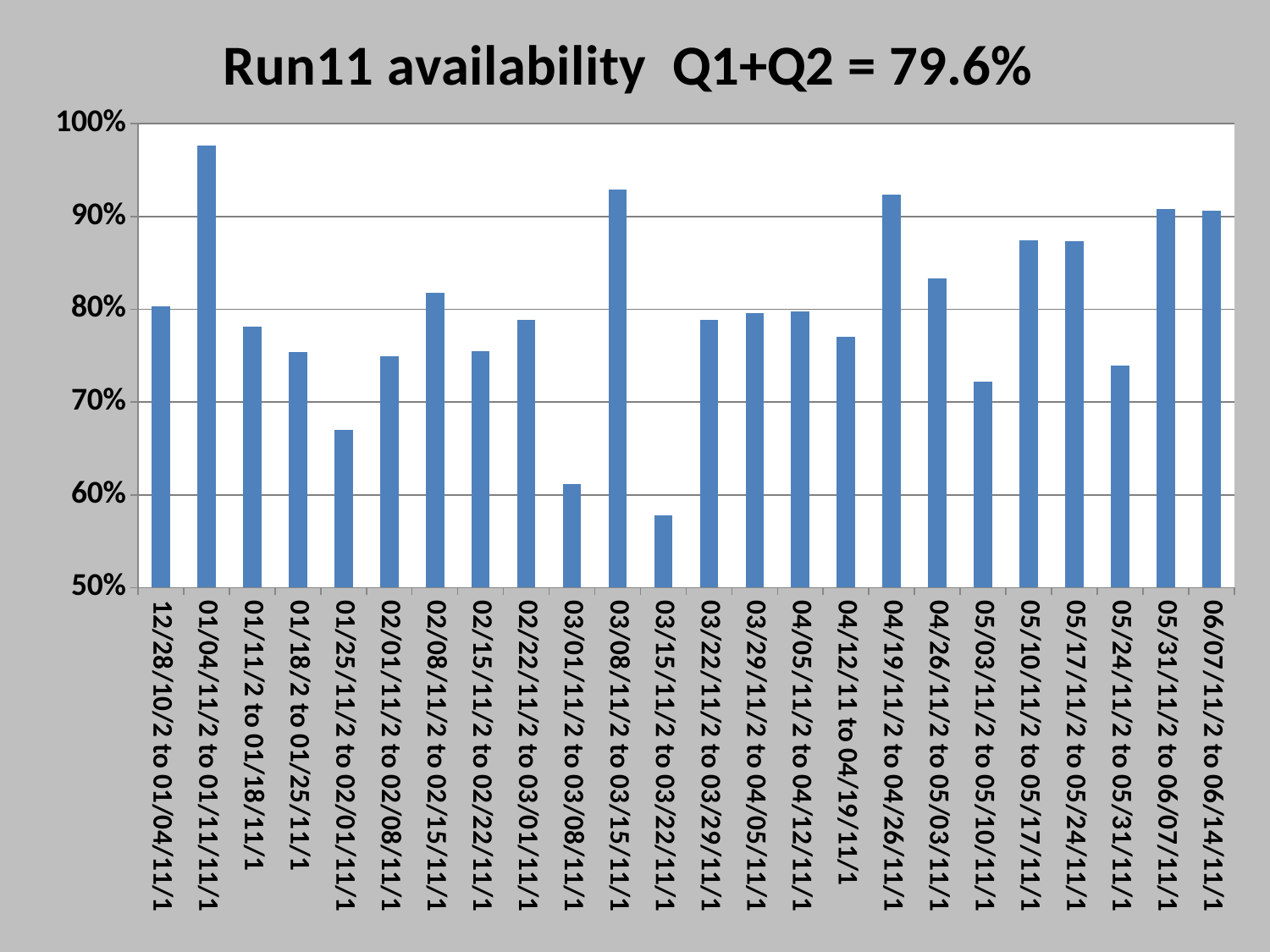
Is the value for 03/01/11/2 to 03/08/11/1 greater or less than 70%? less Which is larger, the value for 02/08/11/2 to 02/15/11/1 or the value for 01/25/11/2 to 02/01/11/1? 02/08/11/2 to 02/15/11/1 Which period has the highest availability? 01/04/11/2 to 01/11/11/1 How many weekly periods (bars) are plotted in the chart? 24 Which period has the lowest availability? 03/15/11/2 to 03/22/11/1 Is the value for 04/12/11 to 04/19/11/1 greater or less than 80%? less Is the value for 01/25/11/2 to 02/01/11/1 greater or less than 70%? less What is the title of the chart? Run11 availability Q1+Q2 = 79.6% What kind of chart is shown on the slide? bar chart Which is larger, the value for 03/08/11/2 to 03/15/11/1 or the value for 05/10/11/2 to 05/17/11/1? 03/08/11/2 to 03/15/11/1 What is the lowest value shown on the vertical axis? 50%